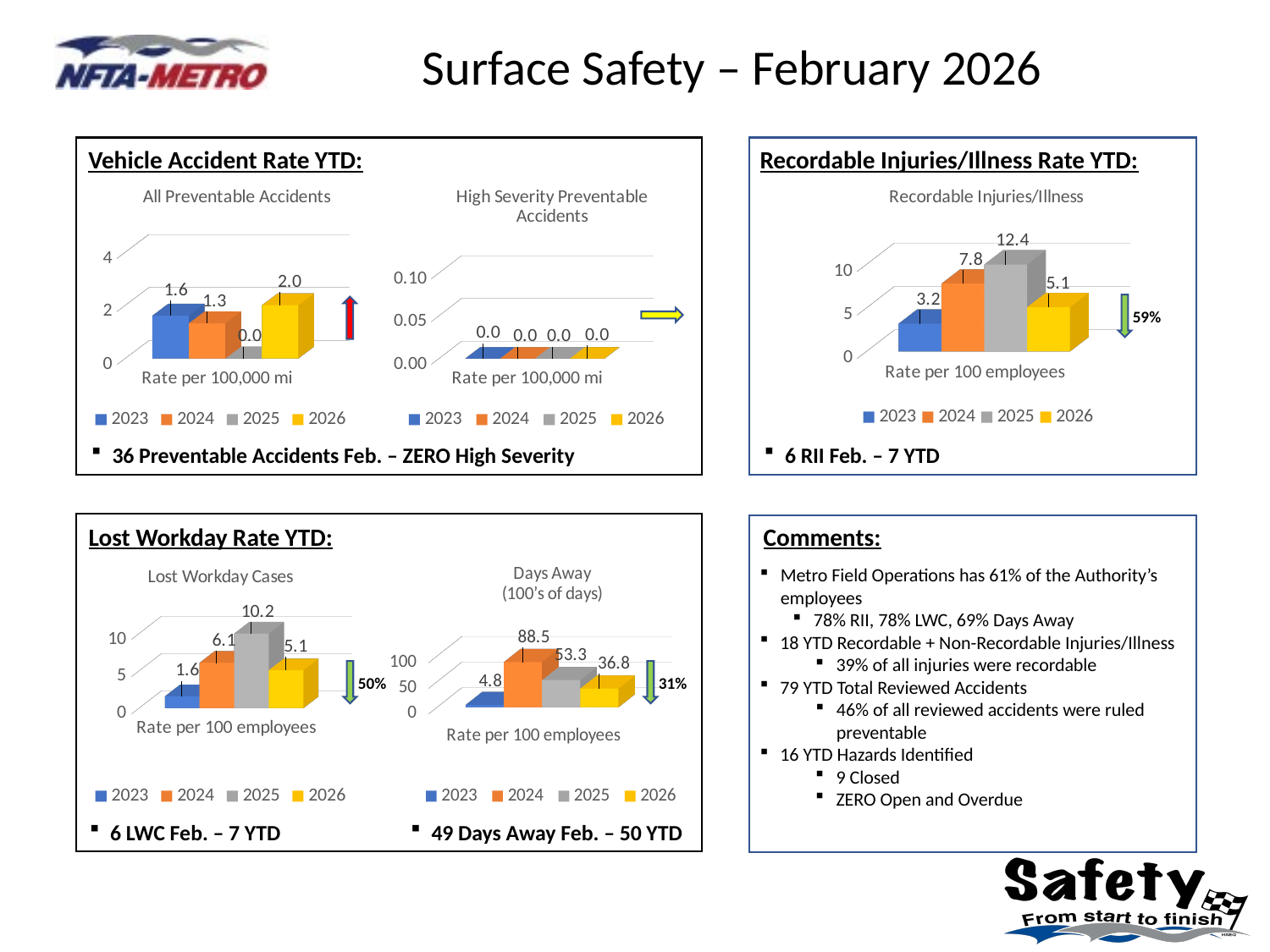
In the Lost Workday Cases chart, which is larger, the value for 2024 or the value for 2026? 2024 In the All Preventable Accidents chart, what is the value for 2026? 2.0 In the Days Away (100's of days) chart, what is the value for 2024? 88.5 In the All Preventable Accidents chart, what is the value for 2025? 0.0 In the Recordable Injuries/Illness chart, what is the difference between the 2025 and 2024 values? 4.6 How many series does the legend of the Lost Workday Cases chart list? 4 In the Lost Workday Cases chart, what is the difference between the 2025 and 2023 values? 8.6 What percentage is shown next to the arrow beside the Recordable Injuries/Illness chart? 59% In the Days Away (100's of days) chart, which year has the lowest value? 2023 What kind of chart is the Recordable Injuries/Illness chart? bar chart In the Recordable Injuries/Illness chart, which year has the highest rate? 2025 In the High Severity Preventable Accidents chart, what is the value for 2025? 0.0